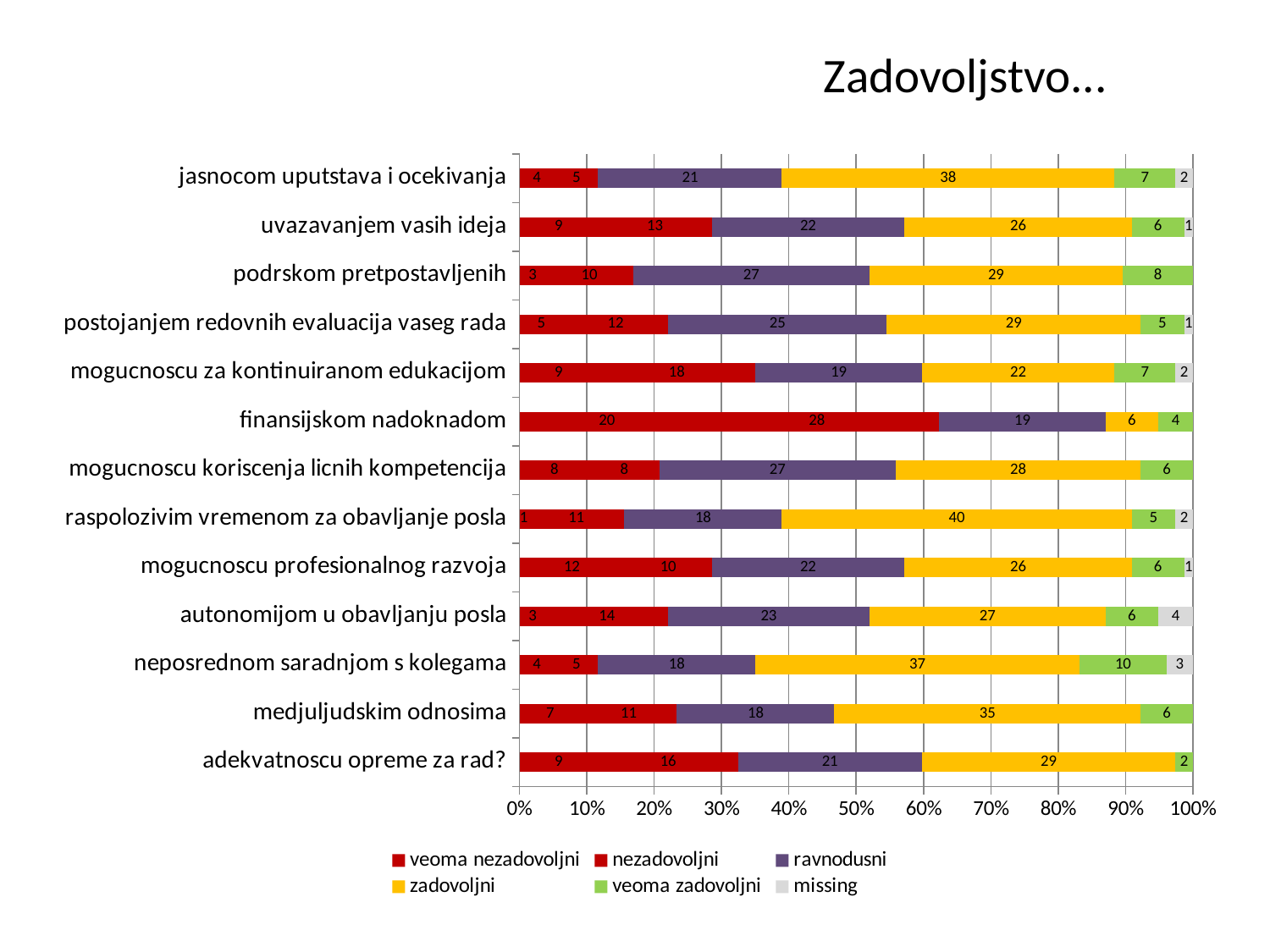
Which has the larger 'zadovoljni' value: 'jasnocom uputstava i ocekivanja' or 'medjuljudskim odnosima'? jasnocom uputstava i ocekivanja What is the 'zadovoljni' value for 'raspolozivim vremenom za obavljanje posla'? 40 What is the difference between the 'ravnodusni' values for 'jasnocom uputstava i ocekivanja' and 'neposrednom saradnjom s kolegama'? 3 What kind of chart is shown on the slide? bar chart Which category has the highest 'veoma zadovoljni' value? neposrednom saradnjom s kolegama What is the 'missing' value for 'autonomijom u obavljanju posla'? 4 Which category has the highest 'zadovoljni' value? raspolozivim vremenom za obavljanje posla How many series does the chart's legend list? 6 What is the 'veoma zadovoljni' value for 'neposrednom saradnjom s kolegama'? 10 What is the 'ravnodusni' value for 'podrskom pretpostavljenih'? 27 How many categories are plotted on the vertical axis of the chart? 13 What is the title of the chart? Zadovoljstvo…